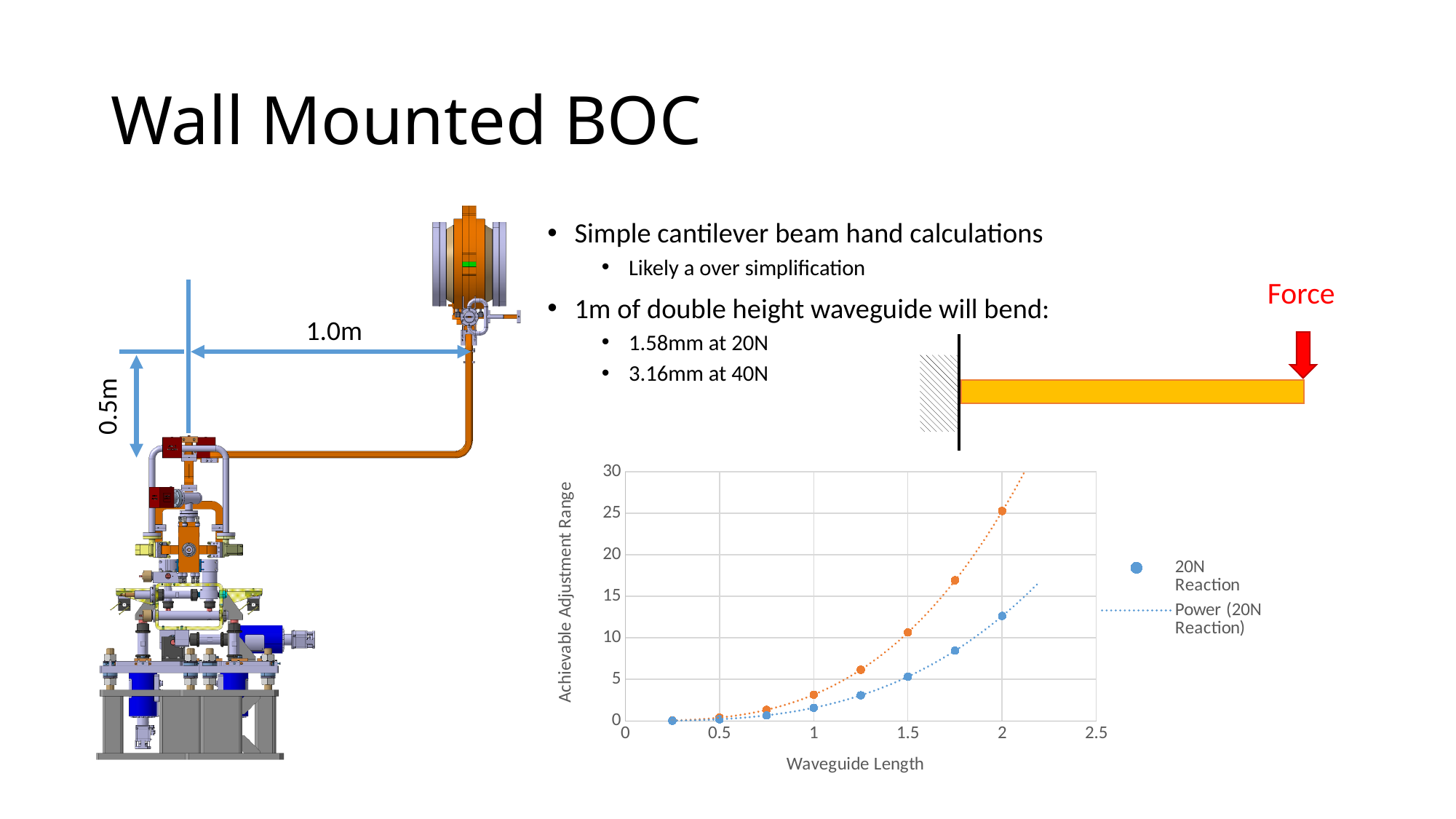
At a Waveguide Length of 2, which series has the larger value, the blue 20N Reaction series or the orange series? the orange series What kind of chart is shown on the slide? scatter chart Is the value of the 20N Reaction series at a Waveguide Length of 2 greater or less than 15? less Do the values of the 20N Reaction series rise or fall as Waveguide Length increases? rise How many entries does the chart's legend list? 2 Is the value of the 20N Reaction series at a Waveguide Length of 2 greater or less than 10? greater How many data points are plotted for the 20N Reaction series? 8 What is the title of the x axis of the chart? Waveguide Length Is the value of the orange series at a Waveguide Length of 2 greater or less than 20? greater What is the title of the y axis of the chart? Achievable Adjustment Range